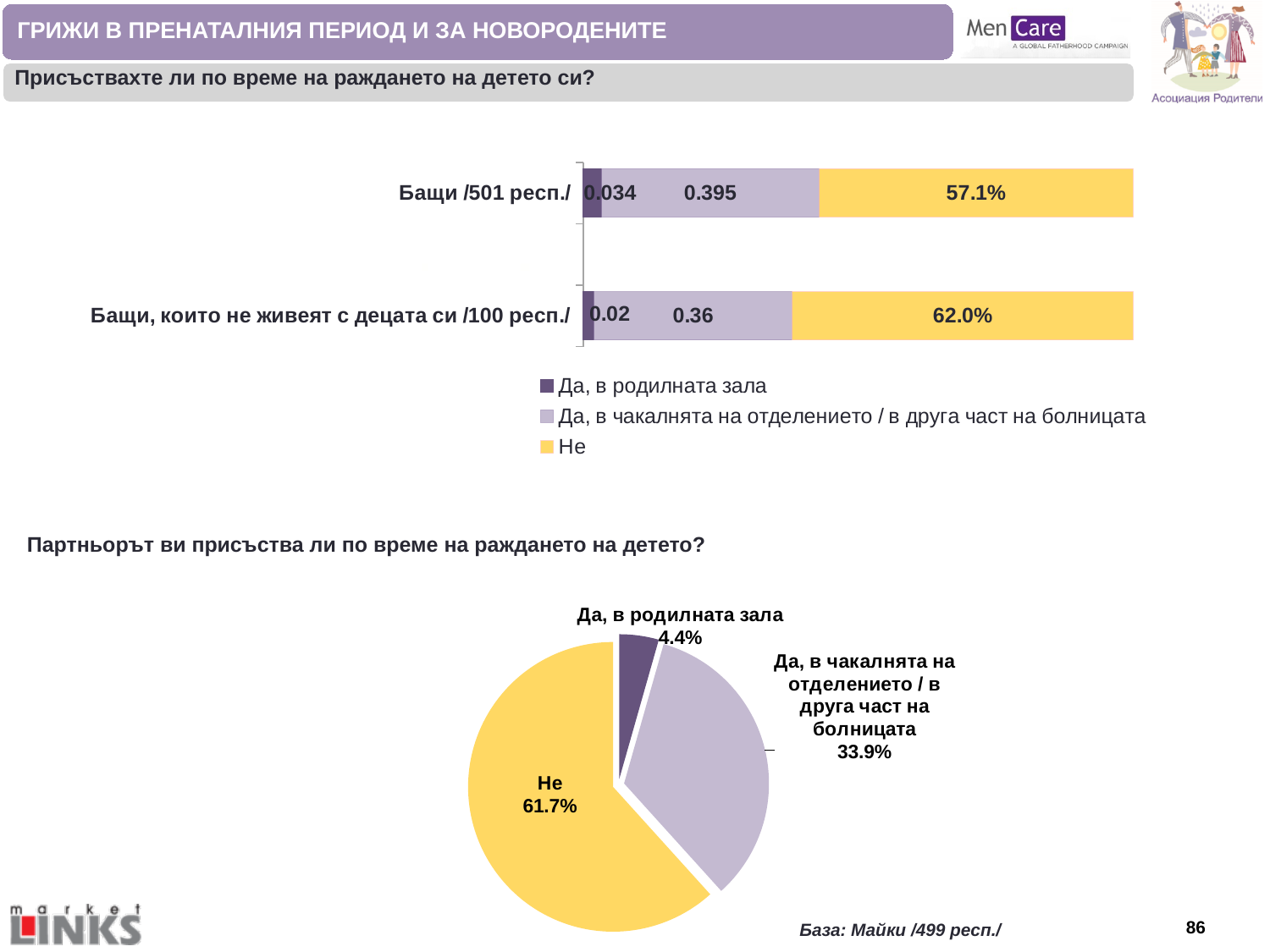
What kind of chart is the top chart on the slide? Stacked bar chart In the top bar chart, what is the value of 'Не' for 'Бащи, които не живеят с децата си /100 респ./'? 62.0% In the top bar chart, what is the value of 'Не' for 'Бащи /501 респ./'? 57.1% In the bottom pie chart, what share does 'Не' have? 61.7% In the top bar chart, what is the value of 'Да, в родилната зала' for 'Бащи /501 респ./'? 0.034 In the bottom pie chart, what share does 'Да, в родилната зала' have? 4.4% In the top bar chart, which category has the higher 'Не' value? Бащи, които не живеят с децата си /100 респ./ How many series does the legend of the top bar chart list? 3 In the bottom pie chart, what is the difference between the 'Не' slice and the 'Да, в чакалнята на отделението / в друга част на болницата' slice? 27.8% How many categories are shown in the top bar chart? 2 In the bottom pie chart, which slice is the largest? Не In the top bar chart, what is the value of 'Да, в чакалнята на отделението / в друга част на болницата' for 'Бащи, които не живеят с децата си /100 респ./'? 0.36